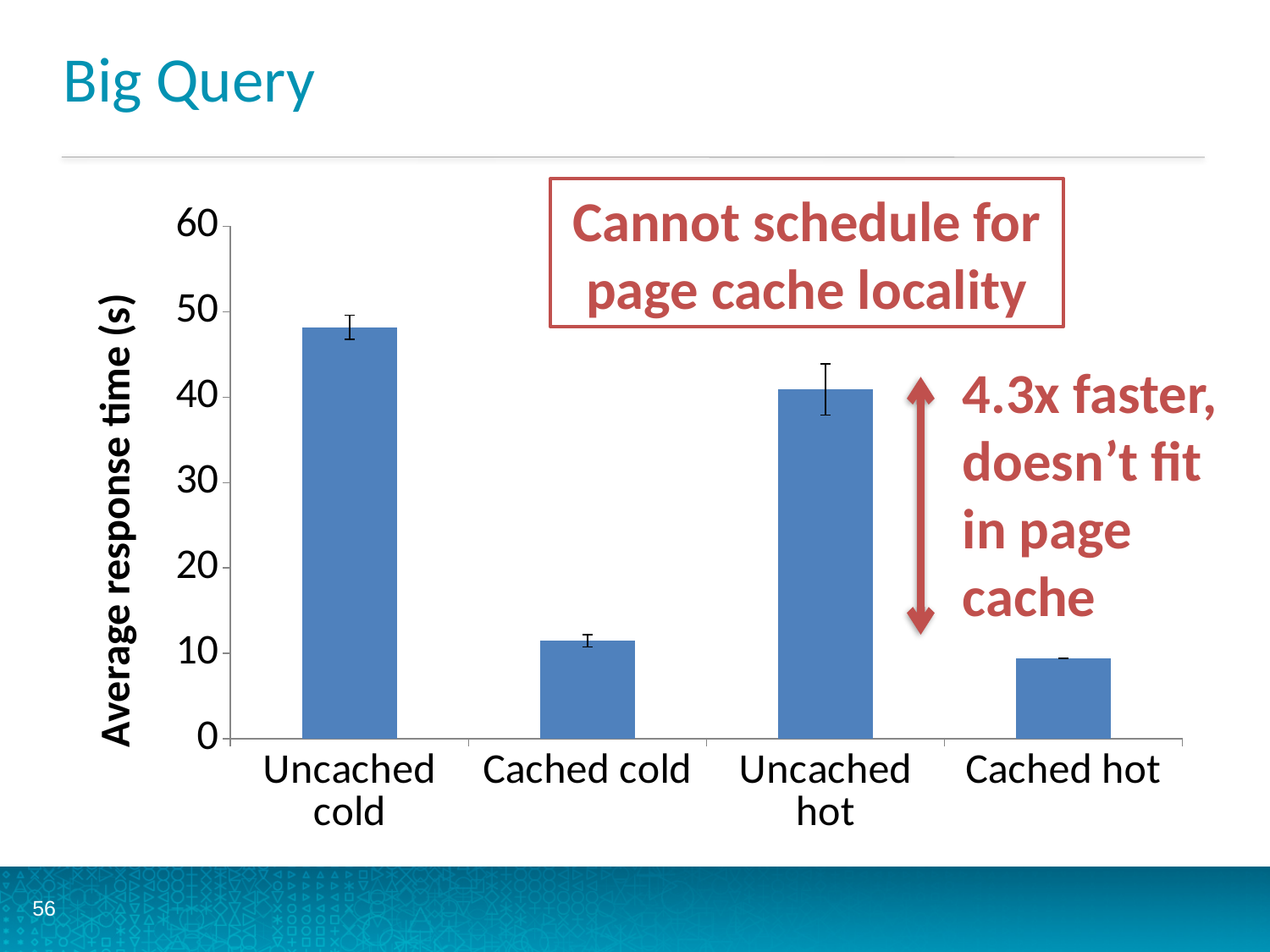
What kind of chart is shown on the slide? bar chart How many categories are plotted on the x axis? 4 Which category has the lowest average response time? Cached hot Which category has the highest average response time? Uncached cold Is the value for Uncached cold greater or less than 40? greater Which is larger, the value for Uncached hot or the value for Cached hot? Uncached hot Is the value for Uncached hot greater or less than 30? greater What is the title of the slide containing the chart? Big Query What is the label of the y axis? Average response time (s) Which is larger, the value for Cached cold or the value for Uncached cold? Uncached cold Is the value for Cached cold greater or less than 20? less